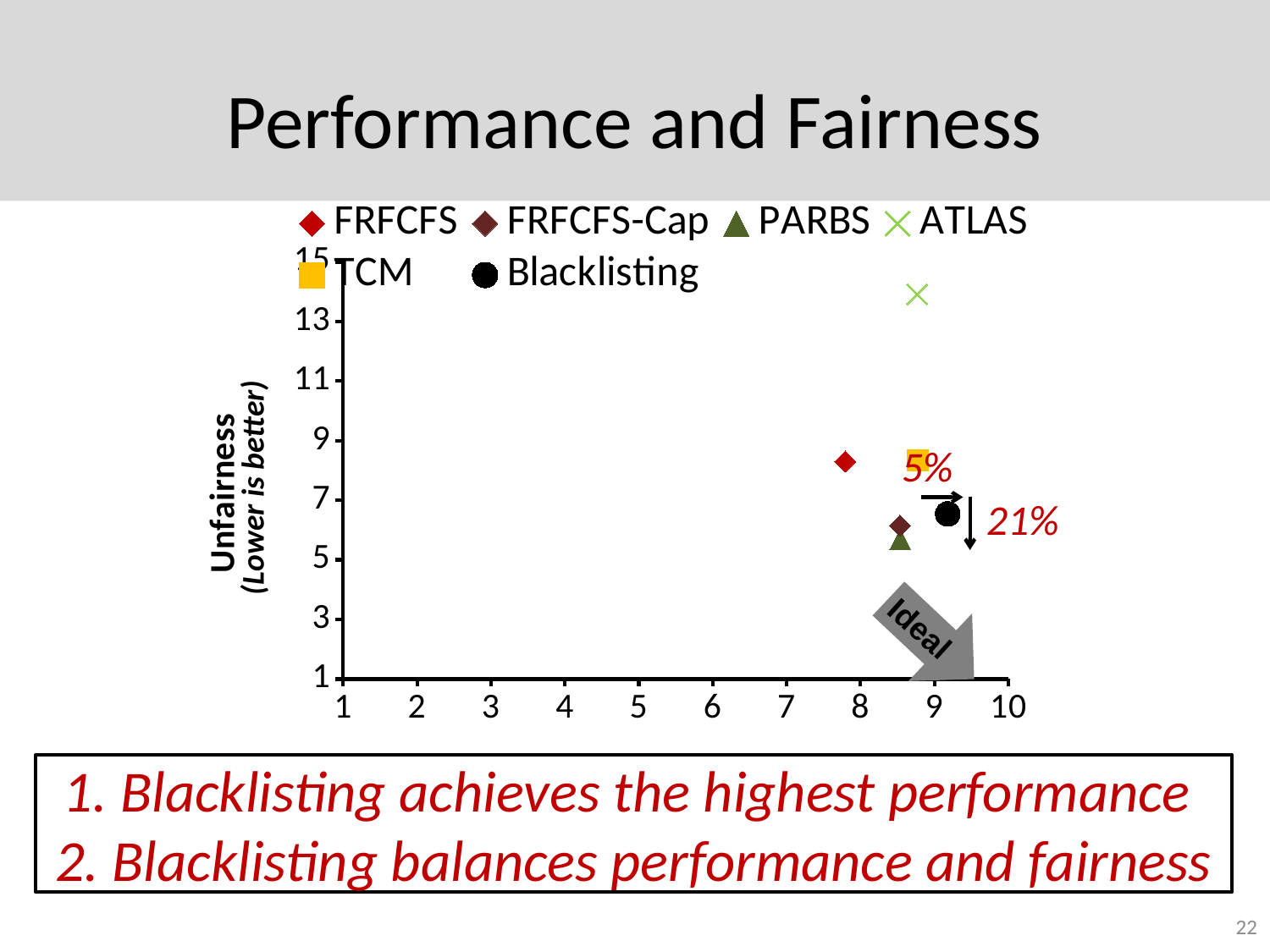
Is the unfairness value for PARBS greater or less than 7? less Is the unfairness value for FRFCFS greater or less than 7? greater Is the unfairness value for ATLAS greater or less than 13? greater How many series does the legend list? 6 Which series has the highest unfairness value? ATLAS Which has the higher unfairness value, TCM or PARBS? TCM Which has the higher unfairness value, ATLAS or FRFCFS? ATLAS What kind of chart is shown on the slide? scatter chart What is the label on the y axis of the chart? Unfairness (Lower is better) Which series is plotted furthest to the right on the x axis? Blacklisting How many data points are plotted on the chart? 6